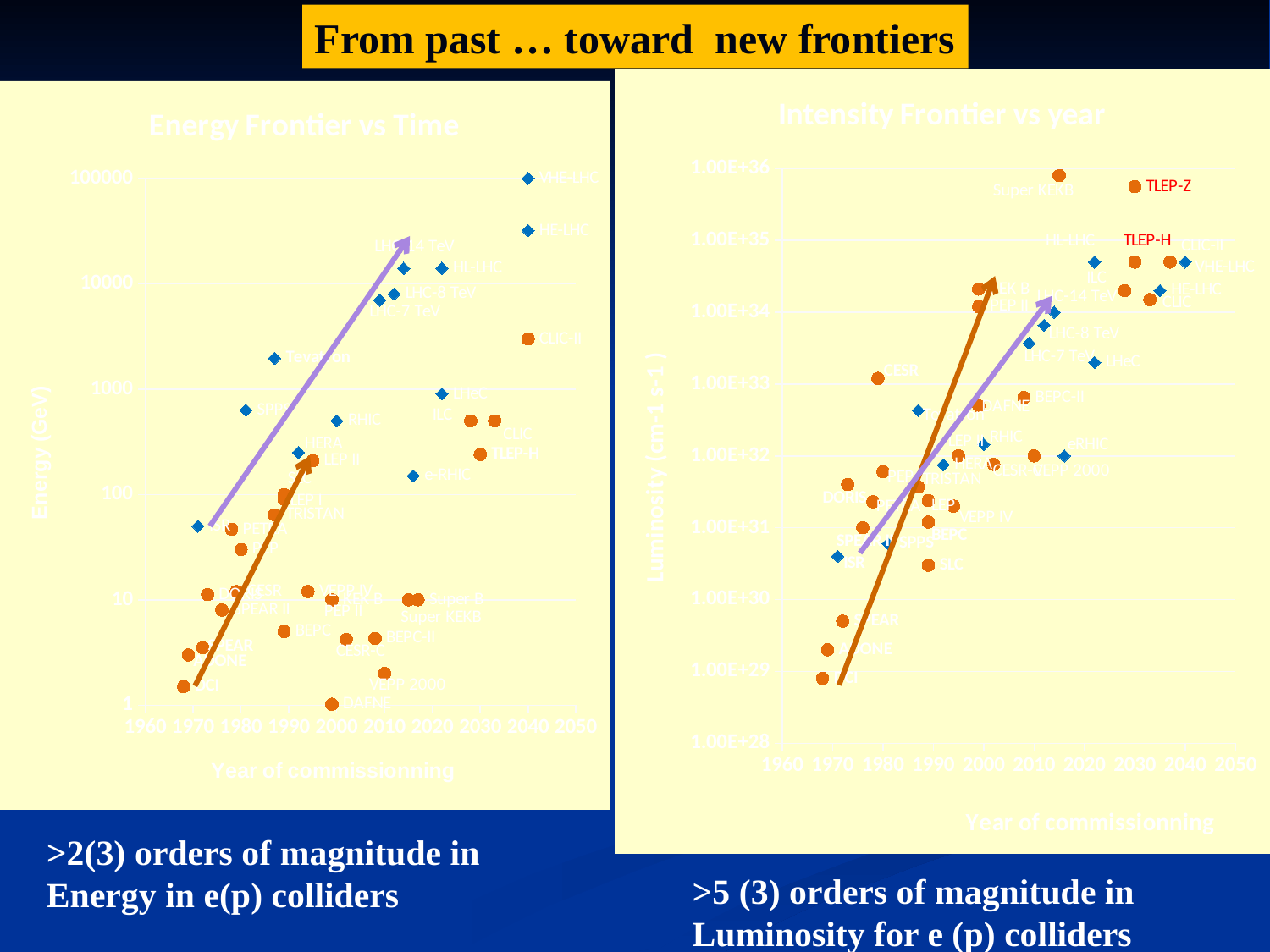
What kind of chart is the 'Energy Frontier vs Time' chart on the left? scatter chart On the 'Energy Frontier vs Time' chart, is the value for Tevatron greater or less than 1000? greater On the 'Energy Frontier vs Time' chart, what is the y-axis title? Energy (GeV) On the 'Intensity Frontier vs year' chart, which has the higher luminosity, TLEP-Z or SLC? TLEP-Z What is the title of the chart on the right side of the slide? Intensity Frontier vs year On the 'Intensity Frontier vs year' chart, is the value for SLC greater or less than 1.00E+31? less On the 'Energy Frontier vs Time' chart, do the energy values generally rise or fall with year of commissioning? rise On the 'Energy Frontier vs Time' chart, which has the higher energy, VHE-LHC or Tevatron? VHE-LHC On the 'Energy Frontier vs Time' chart, which collider has the highest energy? VHE-LHC On the 'Energy Frontier vs Time' chart, is the value for HE-LHC greater or less than 10000? greater